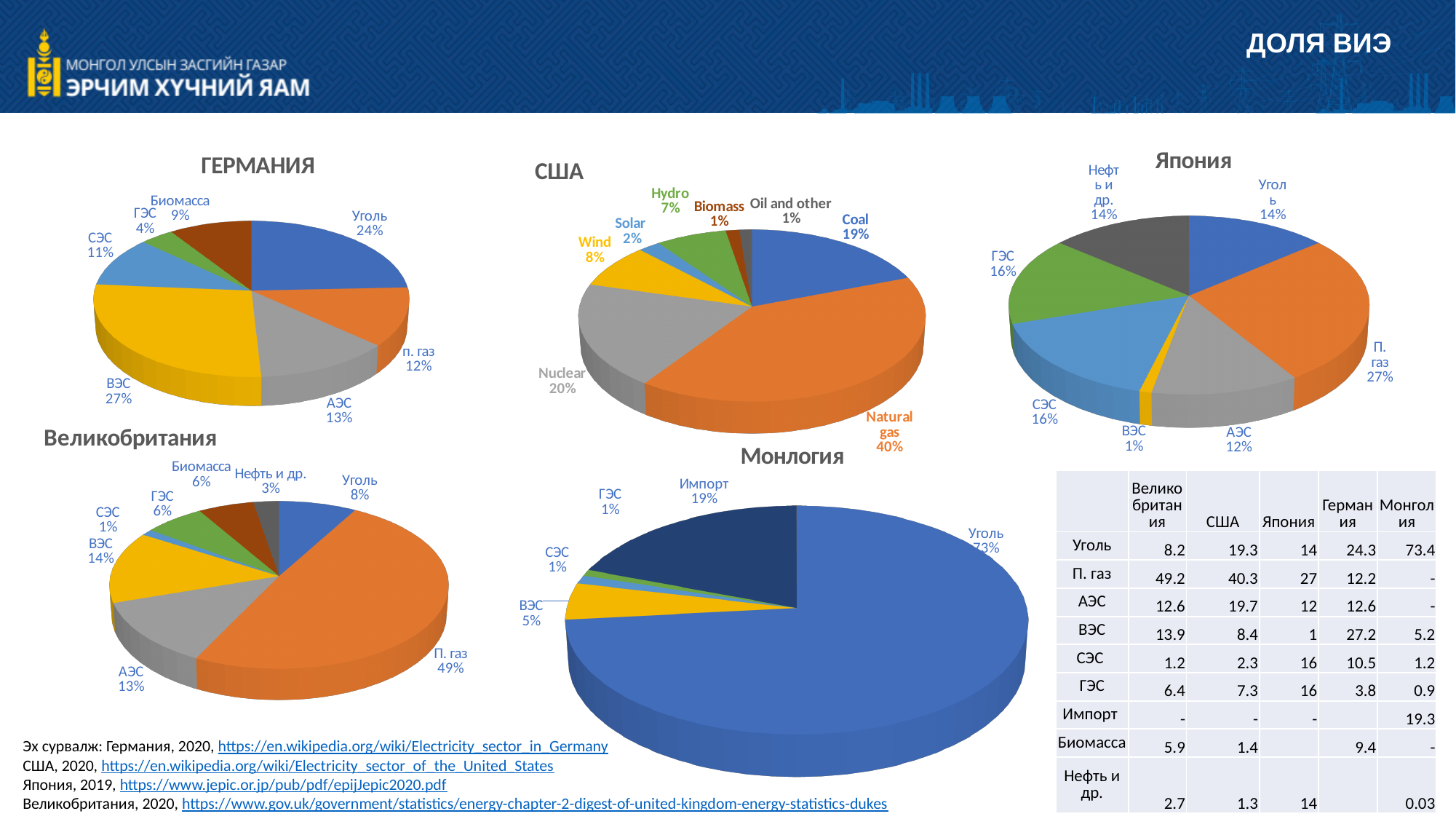
In the Япония pie chart, which category has the smallest share? ВЭС In the ГЕРМАНИЯ pie chart, which category has the largest share? ВЭС In the США pie chart, what is the share of Natural gas? 40% In the ГЕРМАНИЯ pie chart, what share does ВЭС have? 27% In the Монголия pie chart, what is the share of Уголь? 73% In the США pie chart, what is the difference between the Nuclear share and the Coal share? 1% What type of chart is used for Монголия? Pie chart In the Монголия pie chart, how many categories are shown? 5 In the США pie chart, how many categories are shown? 8 In the Великобритания pie chart, what is the share of П. газ? 49% In the Великобритания pie chart, which is larger, the share of ВЭС or the share of АЭС? ВЭС In the Япония pie chart, which category has the largest share? П. газ